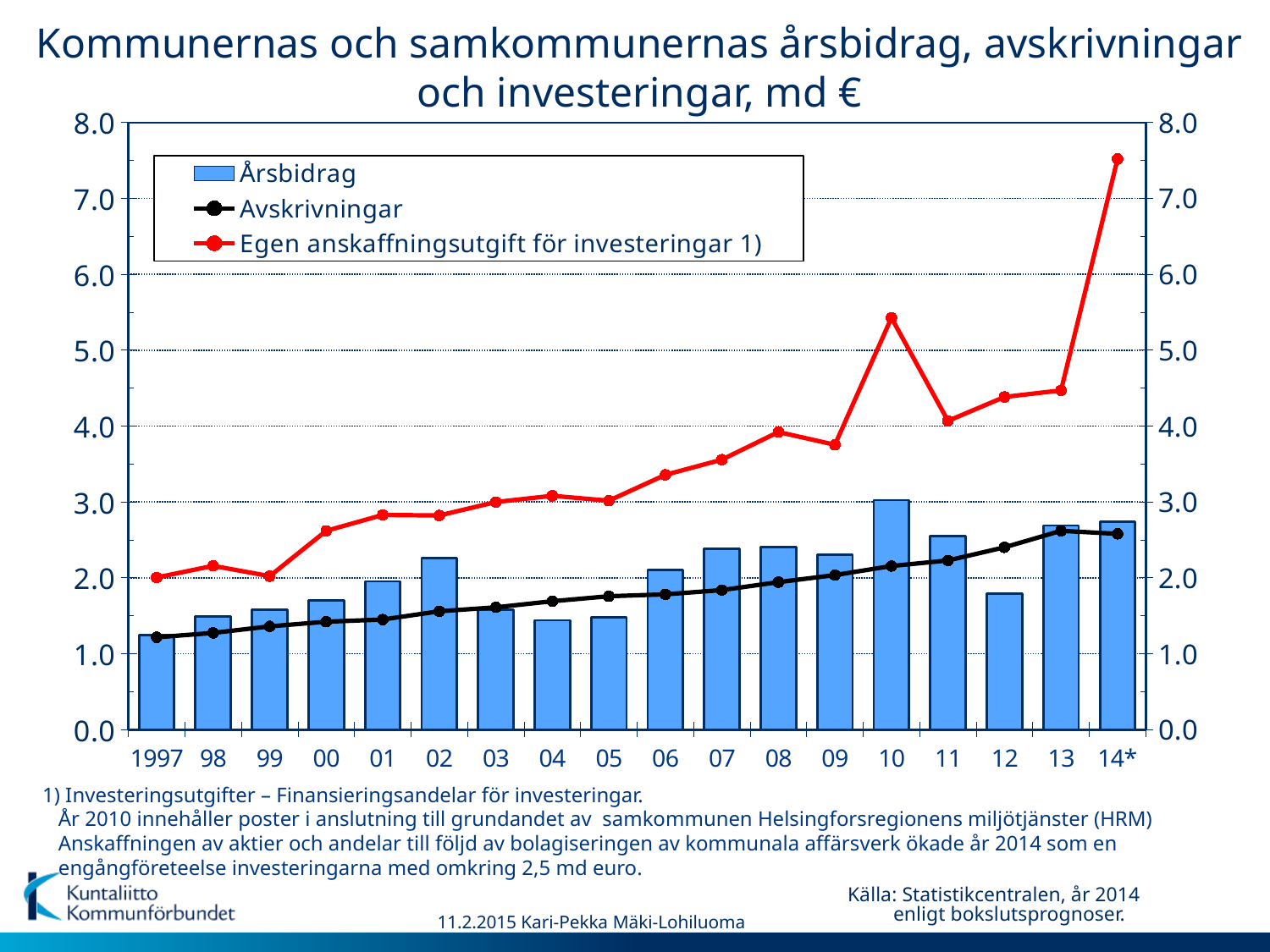
Is the Årsbidrag value for 12 greater or less than 2.0? less In which year is the Årsbidrag bar shortest? 1997 Does the Avskrivningar line generally rise or fall from 1997 to 14*? Rise How many series does the legend list? 3 In which year is the Årsbidrag bar tallest? 10 Which year has the larger Egen anskaffningsutgift för investeringar value, 10 or 11? 10 How many years are shown on the x axis? 18 Is the Egen anskaffningsutgift för investeringar value for 14* greater or less than 7.0? greater Which series is drawn as bars? Årsbidrag In which year is the Egen anskaffningsutgift för investeringar value highest? 14* What kind of chart is shown on the slide? A combined bar and line chart Which series is drawn with a red line? Egen anskaffningsutgift för investeringar 1)